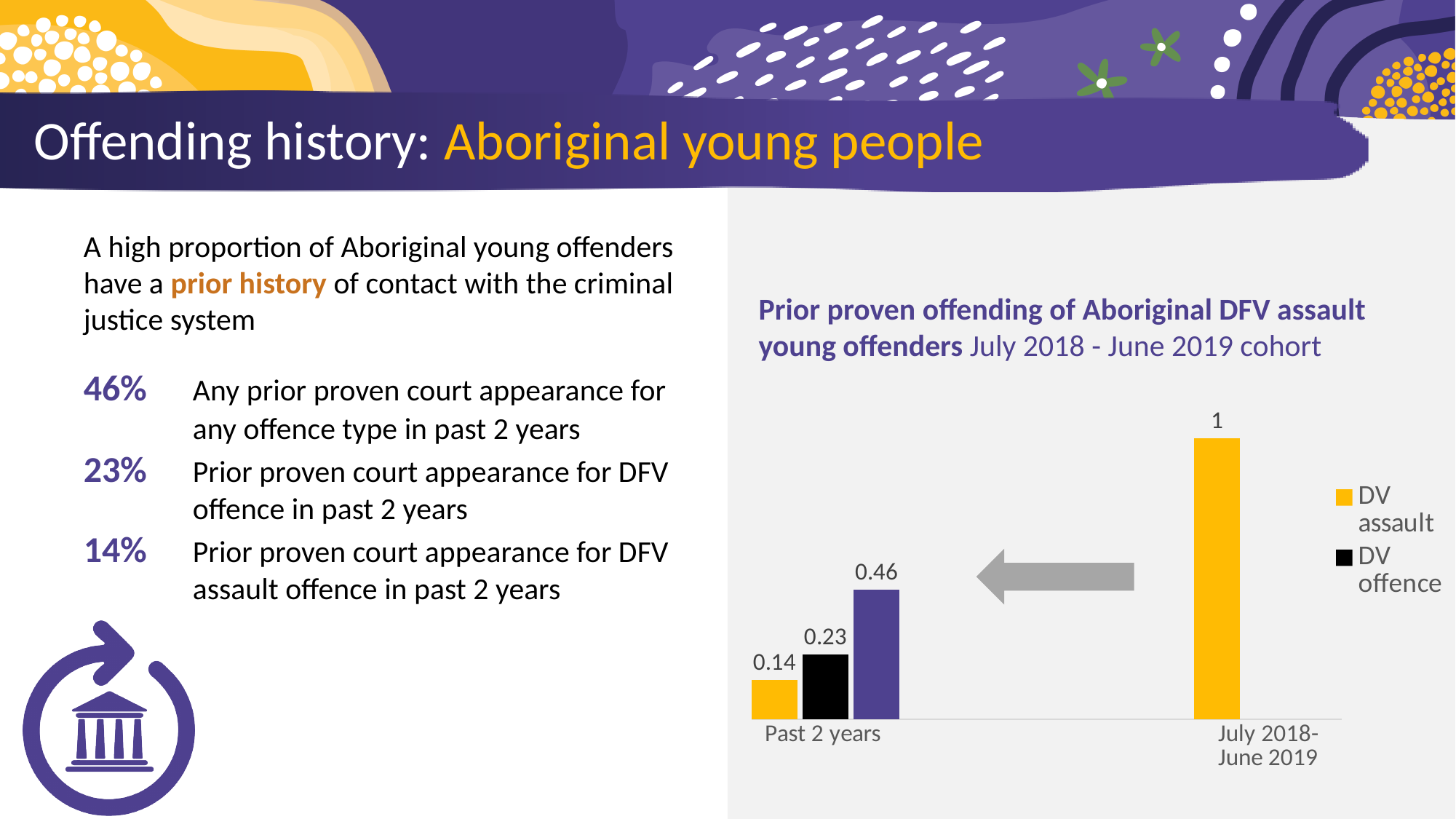
Is the DV offence value or the DV assault value larger for Past 2 years? DV offence What is the value of the DV offence bar for Past 2 years? 0.23 What is the difference between the DV offence and DV assault values for Past 2 years? 0.09 What colour represents the DV assault series in the chart? Yellow How many series does the chart legend list? 2 Which category has the higher DV assault value, Past 2 years or July 2018-June 2019? July 2018-June 2019 Within the Past 2 years group, which bar is the lowest? DV assault How many categories are shown on the x axis of the chart? 2 What value is labelled on the purple bar in the Past 2 years group? 0.46 What type of chart is shown on the slide? Bar chart What is the value of the DV assault bar for Past 2 years? 0.14 What is the value of the DV assault bar for July 2018-June 2019? 1